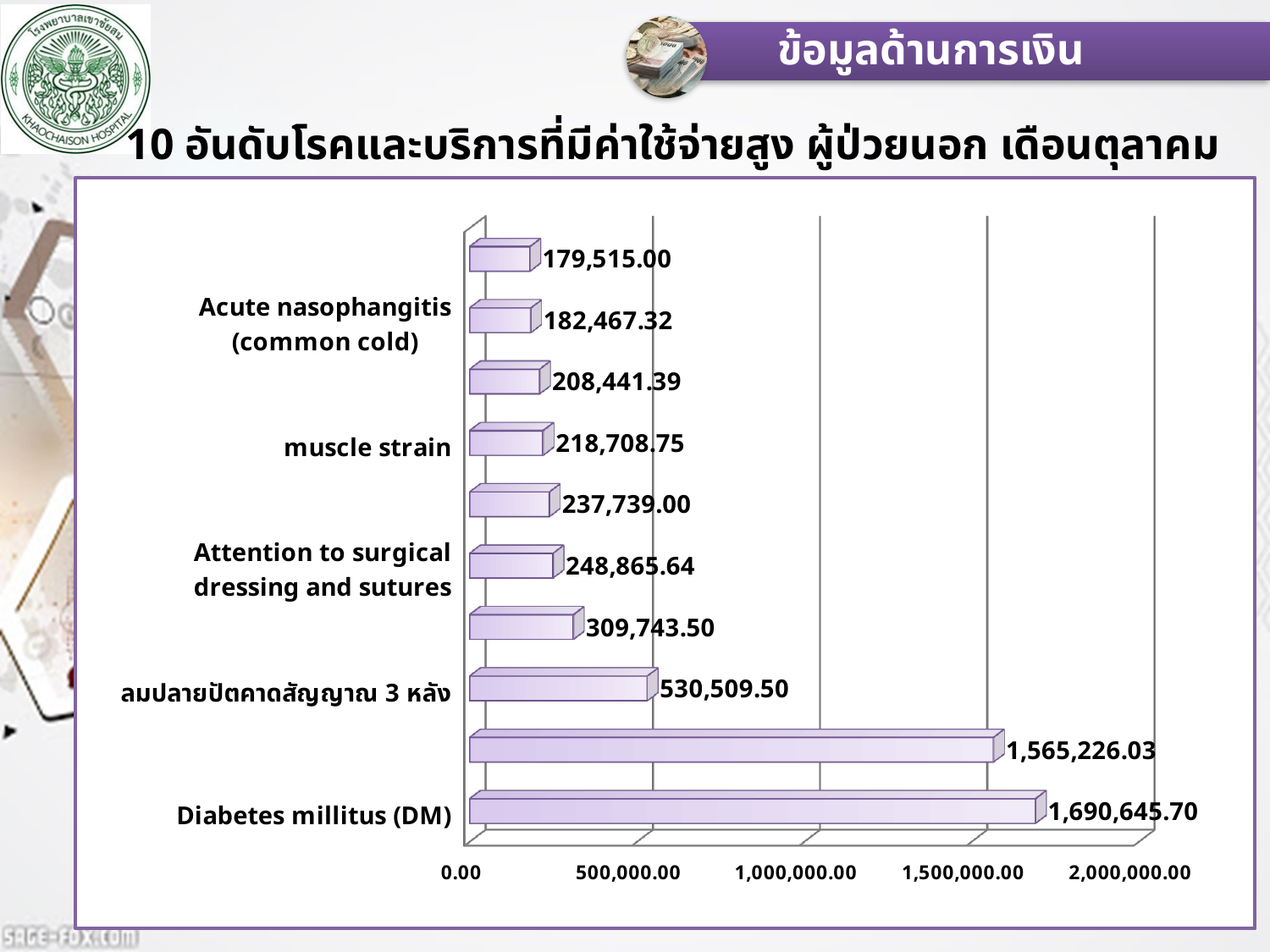
Is the value for Diabetes millitus (DM) greater or less than 1,500,000.00? greater What is the value shown for muscle strain? 218,708.75 What is the value shown for Diabetes millitus (DM)? 1,690,645.70 What is the value shown for ลมปลายปัตคาดสัญญาณ 3 หลัง? 530,509.50 What kind of chart is shown on the slide? Bar chart What is the difference between the values for Diabetes millitus (DM) and muscle strain? 1,471,936.95 What is the value shown for Attention to surgical dressing and sutures? 248,865.64 How many bars are plotted in the chart? 10 What is the value shown for Acute nasophangitis (common cold)? 182,467.32 What is the smallest value shown on any bar in the chart? 179,515.00 Which category has the highest value in the chart? Diabetes millitus (DM) Which has the larger value, muscle strain or Acute nasophangitis (common cold)? muscle strain